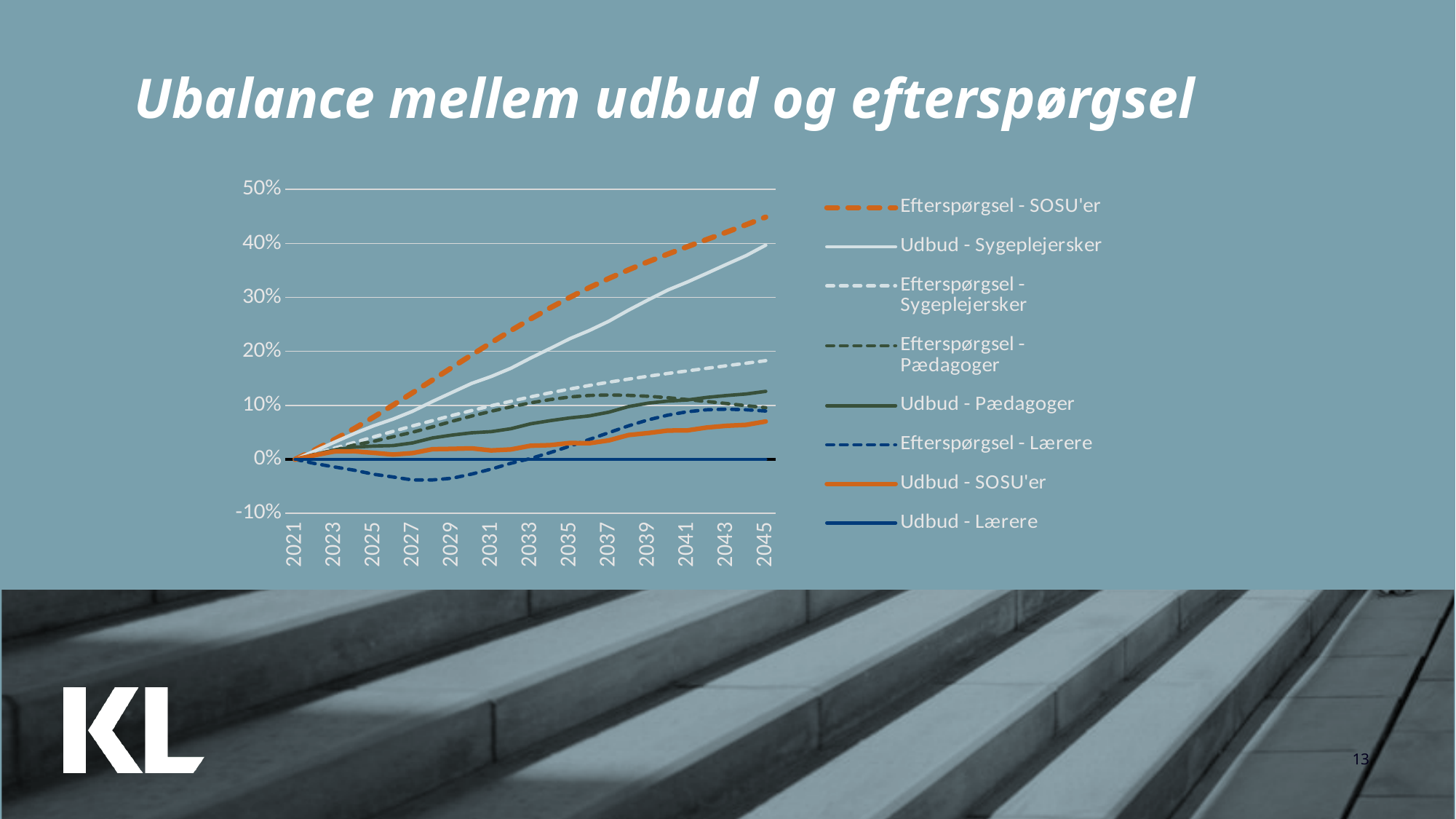
Does the Efterspørgsel - SOSU'er line rise or fall from 2021 to 2045? rises Is the value for Udbud - SOSU'er in 2045 greater or less than 10%? less Is the value for Efterspørgsel - SOSU'er in 2045 greater or less than 40%? greater In 2045, which is larger: Udbud - Sygeplejersker or Efterspørgsel - Sygeplejersker? Udbud - Sygeplejersker How many year labels are shown on the x axis? 13 Is the value for Efterspørgsel - Lærere in 2027 greater or less than 0%? less What is the title of the slide above the chart? Ubalance mellem udbud og efterspørgsel How many series does the legend list? 8 Which series has the highest value in 2045? Efterspørgsel - SOSU'er What kind of chart is shown on the slide? line chart Which series has the lowest value in 2045? Udbud - Lærere